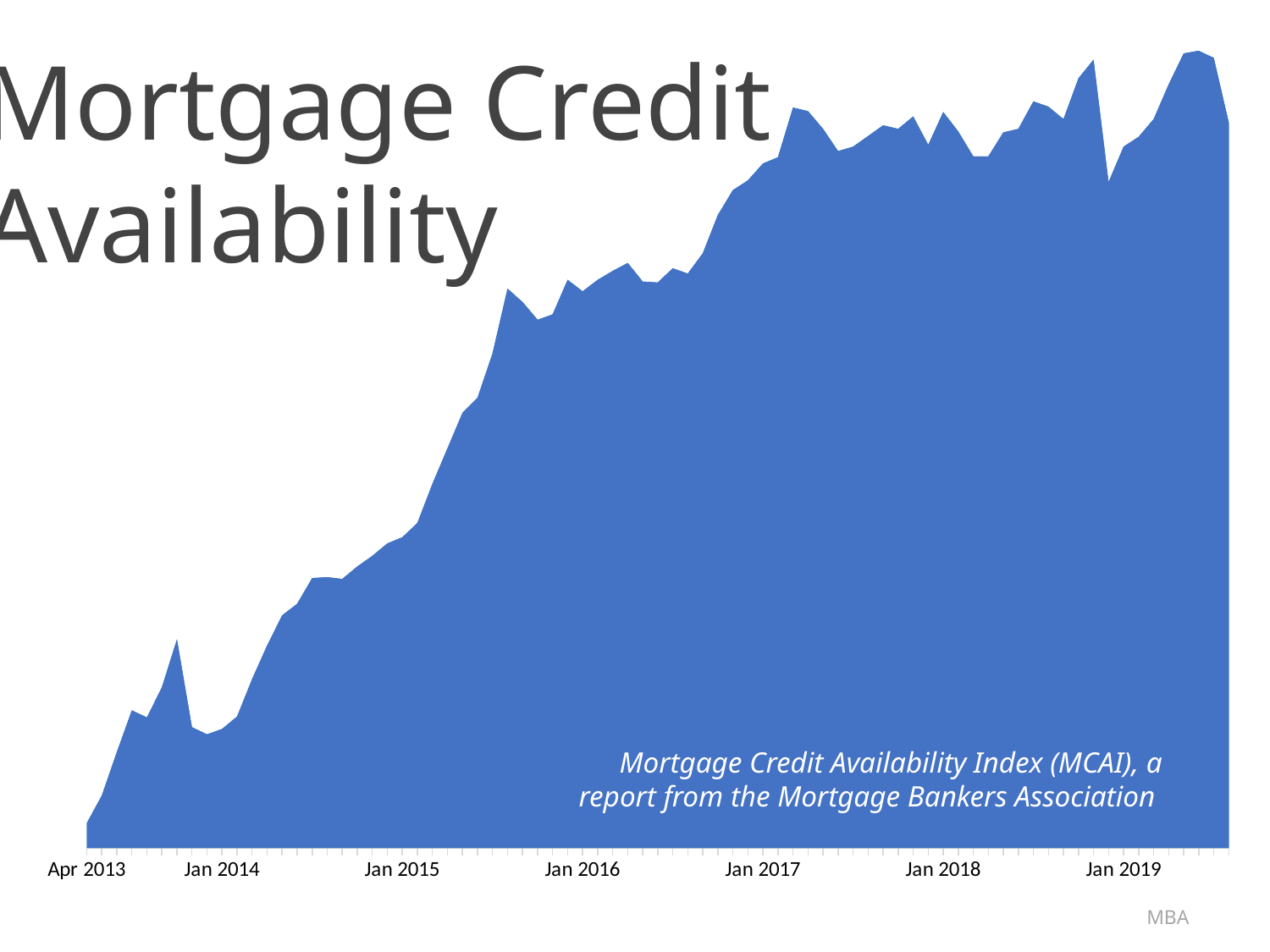
Which x-axis label is the earliest date shown? Apr 2013 Overall, do the values rise or fall from Apr 2013 to 2019? Rise Is the value at Jan 2019 larger or smaller than the value at Jan 2014? Larger Between Jan 2015 and Jan 2016, do the values rise or fall? Rise How many labelled tick marks are shown on the x axis? 7 Which is larger, the value at Jan 2017 or the value at Jan 2014? Jan 2017 At which labelled x-axis date is the plotted value lowest? Apr 2013 Which is larger, the value at Jan 2015 or the value at Jan 2016? Jan 2016 What kind of chart is shown on the slide? Area chart What is the title of the chart on the slide? Mortgage Credit Availability